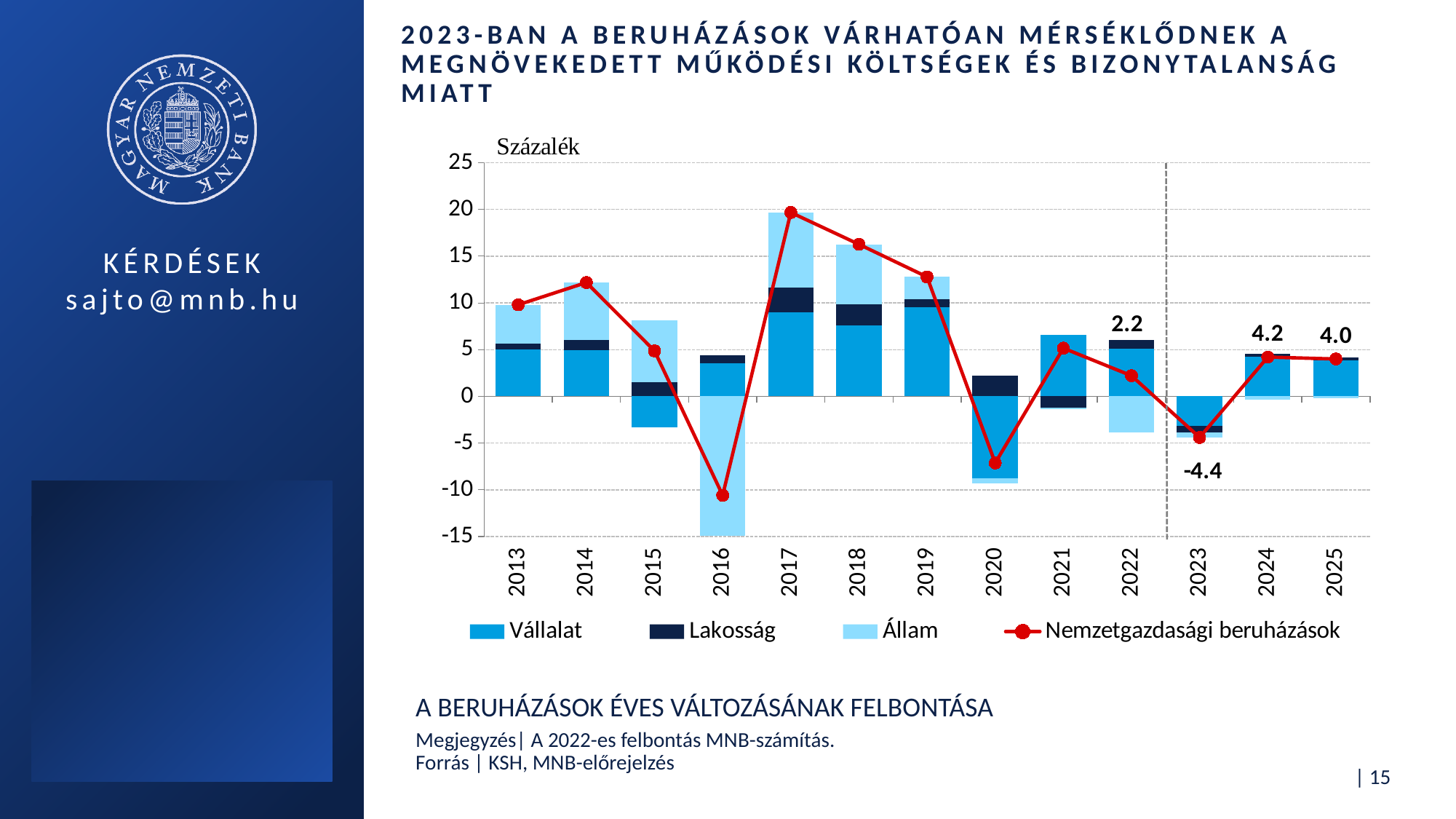
What is the value of Nemzetgazdasági beruházások for 2023? -4.4 What is the value of Nemzetgazdasági beruházások for 2024? 4.2 Is the Nemzetgazdasági beruházások value for 2017 greater or less than 15? greater What is the value of Nemzetgazdasági beruházások for 2025? 4.0 In which year does the Nemzetgazdasági beruházások line reach its lowest point? 2016 What is the difference between the Nemzetgazdasági beruházások values for 2024 and 2023? 8.6 Which is larger, the Nemzetgazdasági beruházások value for 2024 or for 2025? 2024 How many years are shown on the x axis? 13 In which year does the Nemzetgazdasági beruházások line reach its highest point? 2017 How many series does the legend list? 4 What unit label is shown at the top of the vertical axis? Százalék What is the value of Nemzetgazdasági beruházások for 2022? 2.2